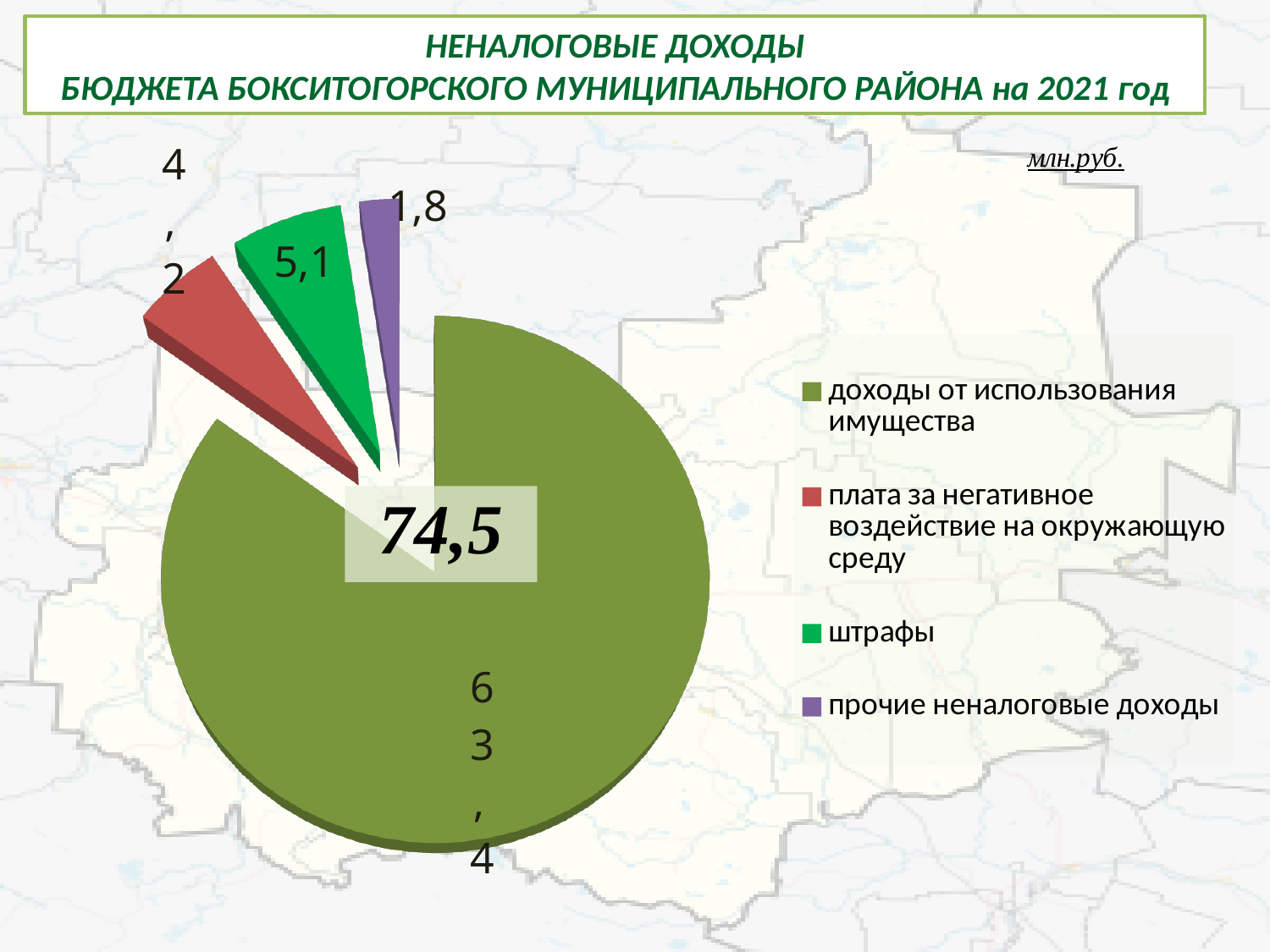
Which is larger, штрафы or плата за негативное воздействие на окружающую среду? штрафы Which category has the smallest slice of the pie? прочие неналоговые доходы How many categories does the pie chart show? 4 What is the value for прочие неналоговые доходы? 1,8 What is the value for штрафы? 5,1 What is the value for плата за негативное воздействие на окружающую среду? 4,2 What is the value for доходы от использования имущества? 63,4 What is the difference between доходы от использования имущества and штрафы? 58,3 What total value is printed in the centre of the pie chart? 74,5 What kind of chart is shown on the slide? pie chart What is the difference between штрафы and прочие неналоговые доходы? 3,3 Which category has the largest slice of the pie? доходы от использования имущества